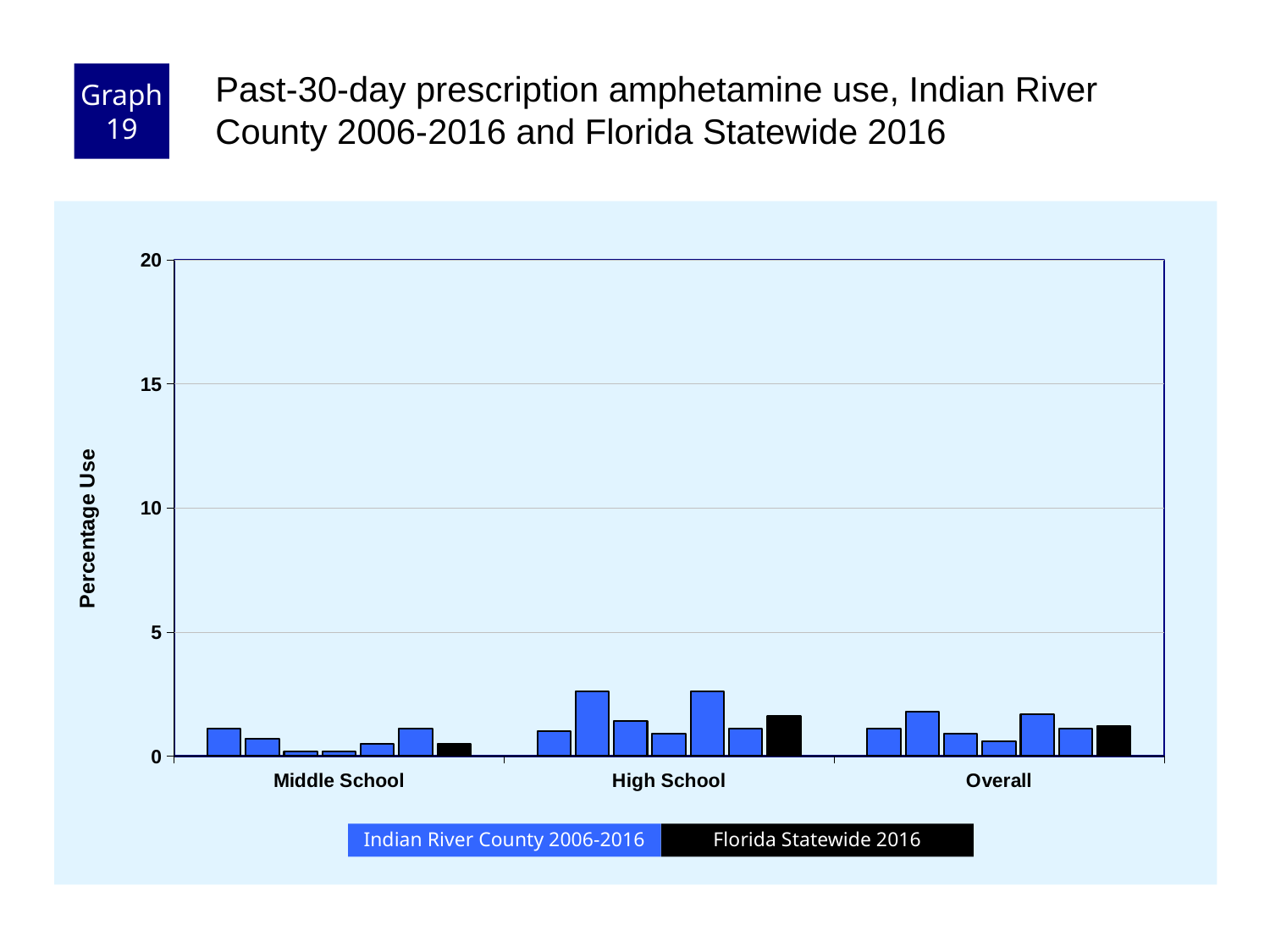
How many series does the legend list? 2 Is the Florida Statewide 2016 value for High School greater or less than 5? less Which category has the lowest Florida Statewide 2016 value? Middle School How many categories are shown along the x axis? 3 Which colour represents Florida Statewide 2016 in the legend? black Which is larger, the Florida Statewide 2016 value for Overall or for Middle School? Overall Which category contains the tallest bar in the chart? High School What is the label on the y axis? Percentage Use Is the Florida Statewide 2016 value for Middle School greater or less than 5? less What kind of chart is shown on the slide? bar chart Is the highest Indian River County bar for High School greater or less than 5? less Which is larger, the Florida Statewide 2016 value for High School or for Middle School? High School